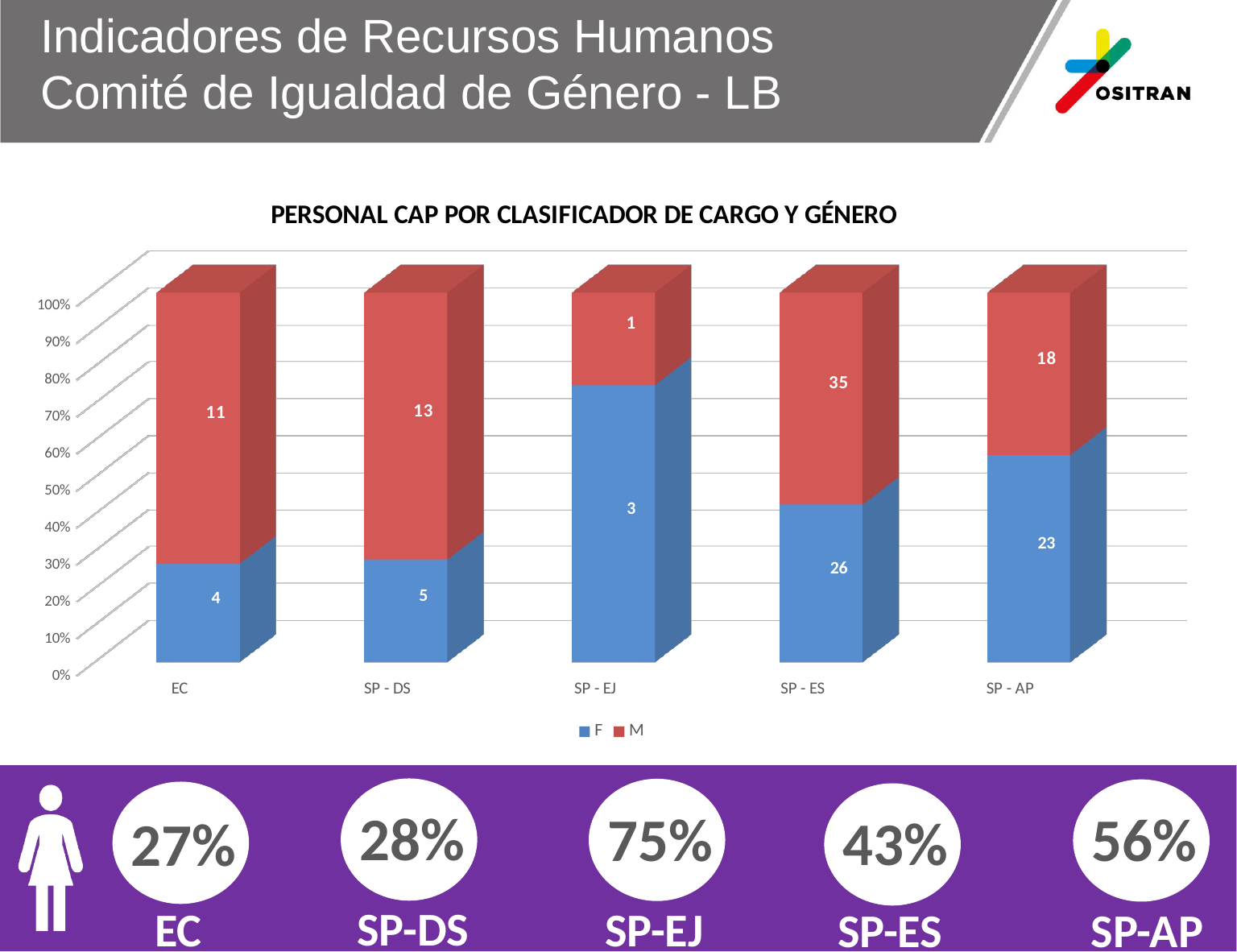
Which category has the highest value for the M series? SP - ES What kind of chart is shown on the slide? Stacked bar chart What is the title of the chart? PERSONAL CAP POR CLASIFICADOR DE CARGO Y GÉNERO Which category has the lowest value for the F series? SP - EJ How many categories are shown on the x axis? 5 What is the value for M in the SP - AP category? 18 In the SP - AP category, which series has the larger value, F or M? F How many series does the legend list? 2 What is the value for F in the SP - ES category? 26 What is the value for F in the EC category? 4 What is the difference between the M and F values in the SP - ES category? 9 What is the total of the F and M values in the SP - DS bar? 18